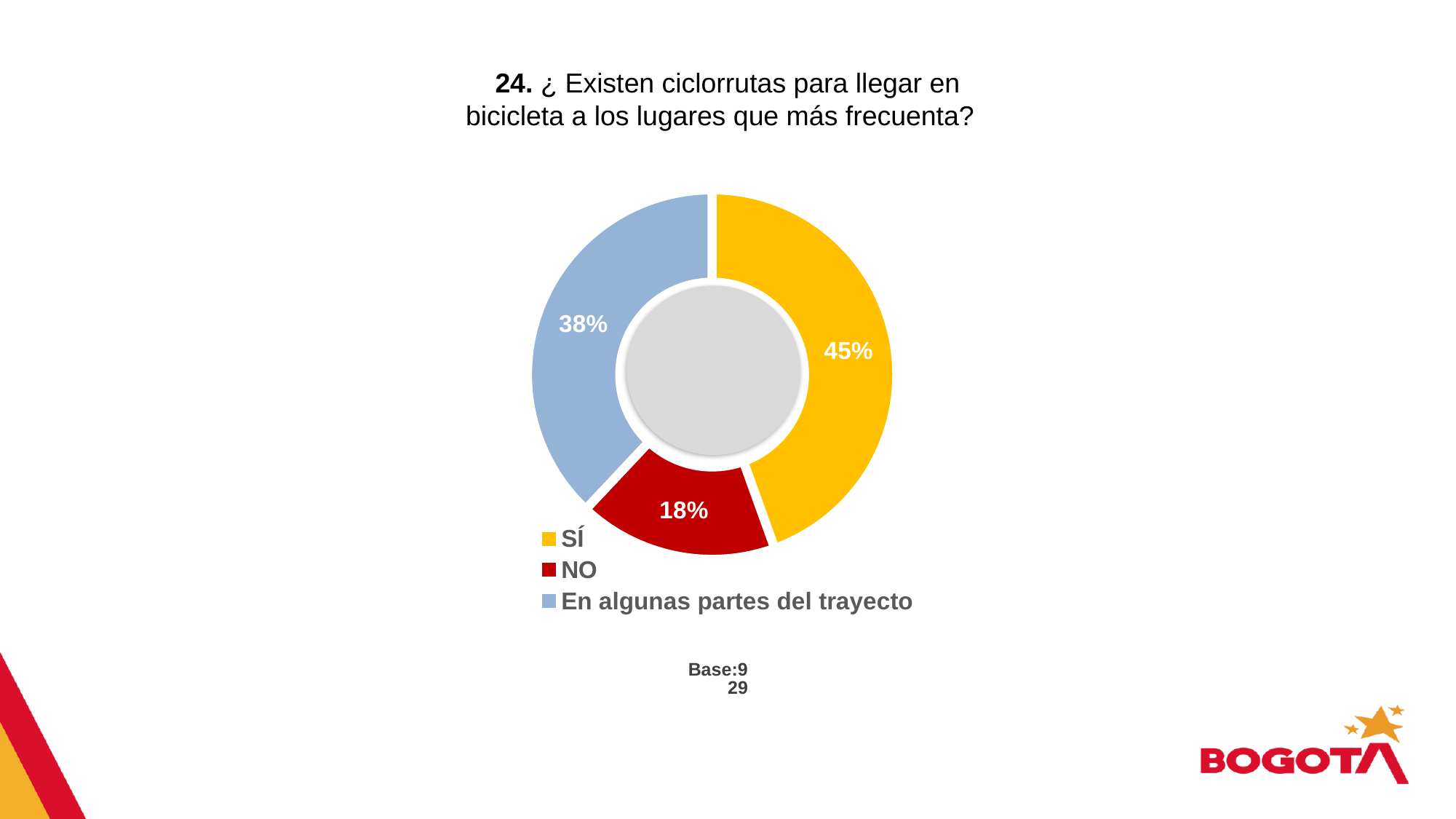
How many response categories does the chart show? 3 What kind of chart is shown on the slide? Pie chart (doughnut) What colour represents the NO response in the chart? Red What percentage of respondents answered NO? 18% Which response has the largest share of the chart? SÍ What is the base (number of respondents) shown below the chart? 929 What percentage of respondents answered 'En algunas partes del trayecto'? 38% Which response has the smallest share of the chart? NO Which is larger, the share for NO or the share for 'En algunas partes del trayecto'? En algunas partes del trayecto What percentage of respondents answered SÍ? 45% What is the difference in percentage points between SÍ and 'En algunas partes del trayecto'? 7 What is the difference in percentage points between SÍ and NO? 27